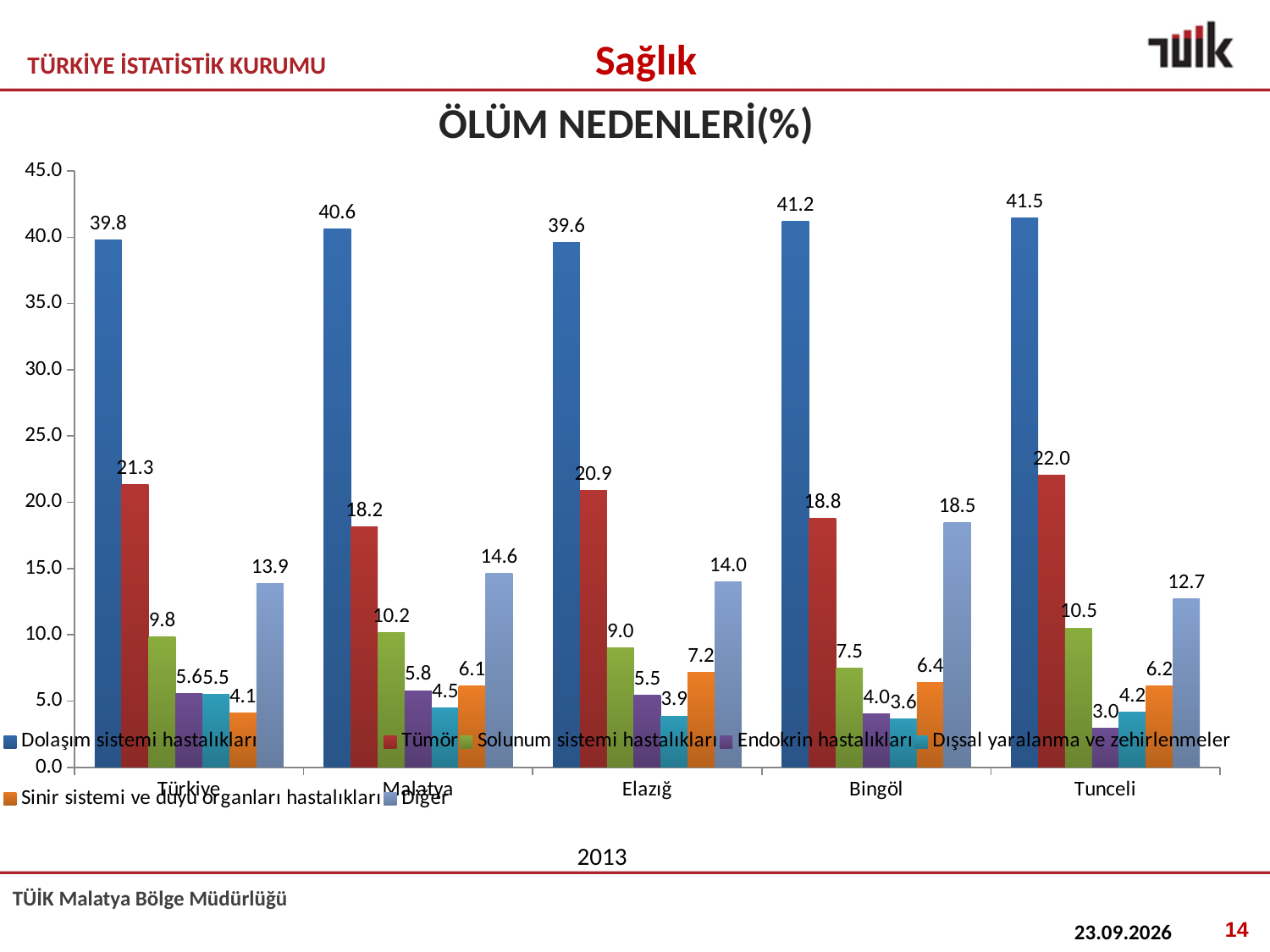
Which province or region has the lowest value for Diğer? Tunceli What is the difference between the Tümör values for Tunceli and Malatya? 3.8 What is the value for Tümör in Elazığ? 20.9 What is the value for Solunum sistemi hastalıkları in Malatya? 10.2 What is the title of the chart? ÖLÜM NEDENLERİ(%) How many series does the legend list? 7 Which is larger, the Diğer value for Malatya or for Elazığ? Malatya What kind of chart is shown on the slide? Bar chart How many provinces or regions are shown on the x axis? 5 What is the value for Diğer in Bingöl? 18.5 Which province or region has the highest value for Dolaşım sistemi hastalıkları? Tunceli What is the value for Dolaşım sistemi hastalıkları in Tunceli? 41.5